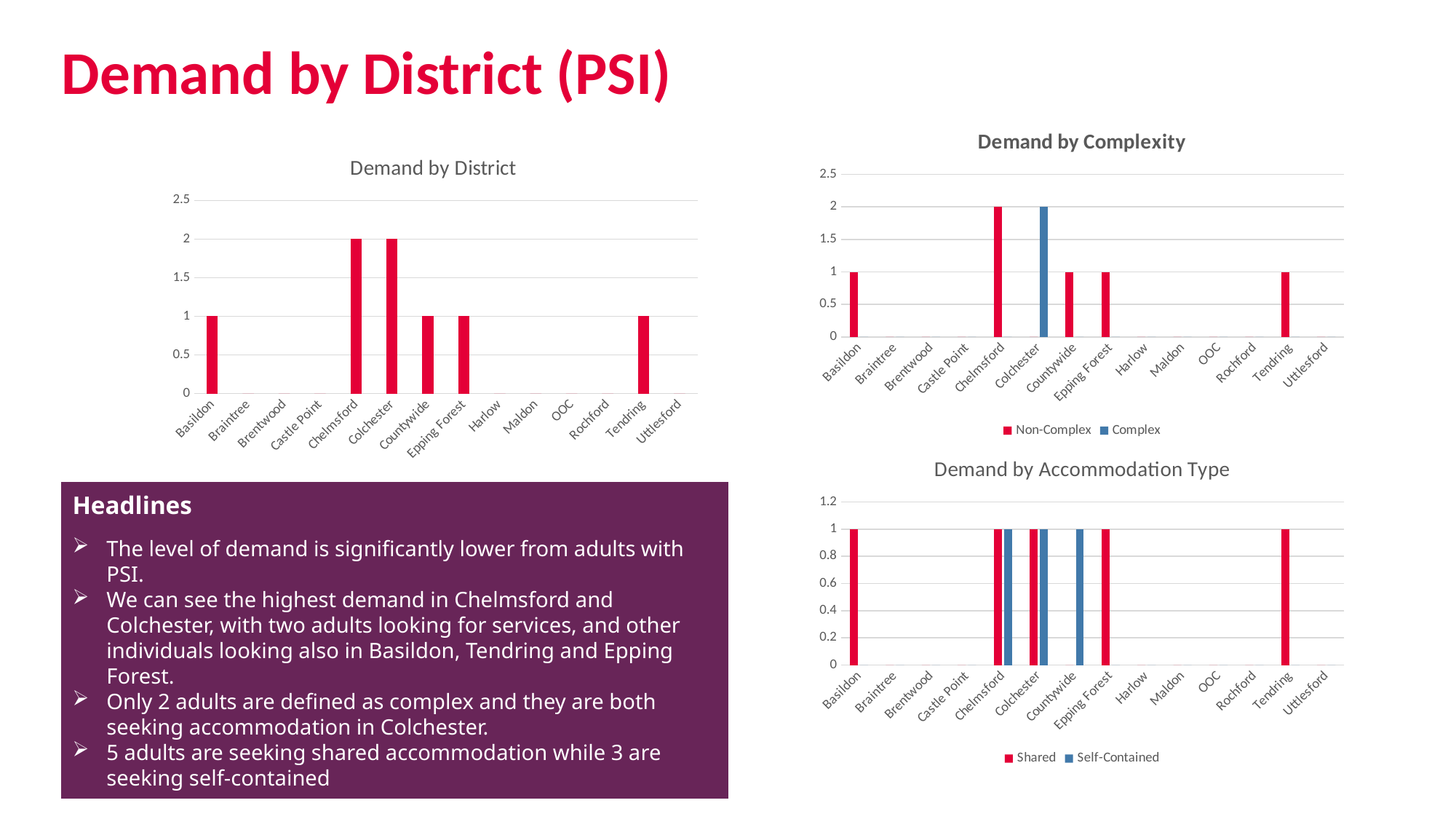
In the 'Demand by District' chart, what is the difference between the values for Colchester and Tendring? 1 In the 'Demand by Complexity' chart, how many series does the legend list? 2 In the 'Demand by District' chart, which is larger, the value for Chelmsford or the value for Epping Forest? Chelmsford What kind of chart is 'Demand by District'? Bar chart In the 'Demand by District' chart, what is the value for Chelmsford? 2 In the 'Demand by Accommodation Type' chart, what are the two legend entries? Shared and Self-Contained In the 'Demand by District' chart, how many districts are listed on the x axis? 14 In the 'Demand by Complexity' chart, what is the Complex value for Colchester? 2 In the 'Demand by Complexity' chart, what is the Non-Complex value for Chelmsford? 2 In the 'Demand by Accommodation Type' chart, what is the Self-Contained value for Countywide? 1 In the 'Demand by District' chart, what is the value for Basildon? 1 In the 'Demand by Accommodation Type' chart, what is the Shared value for Tendring? 1